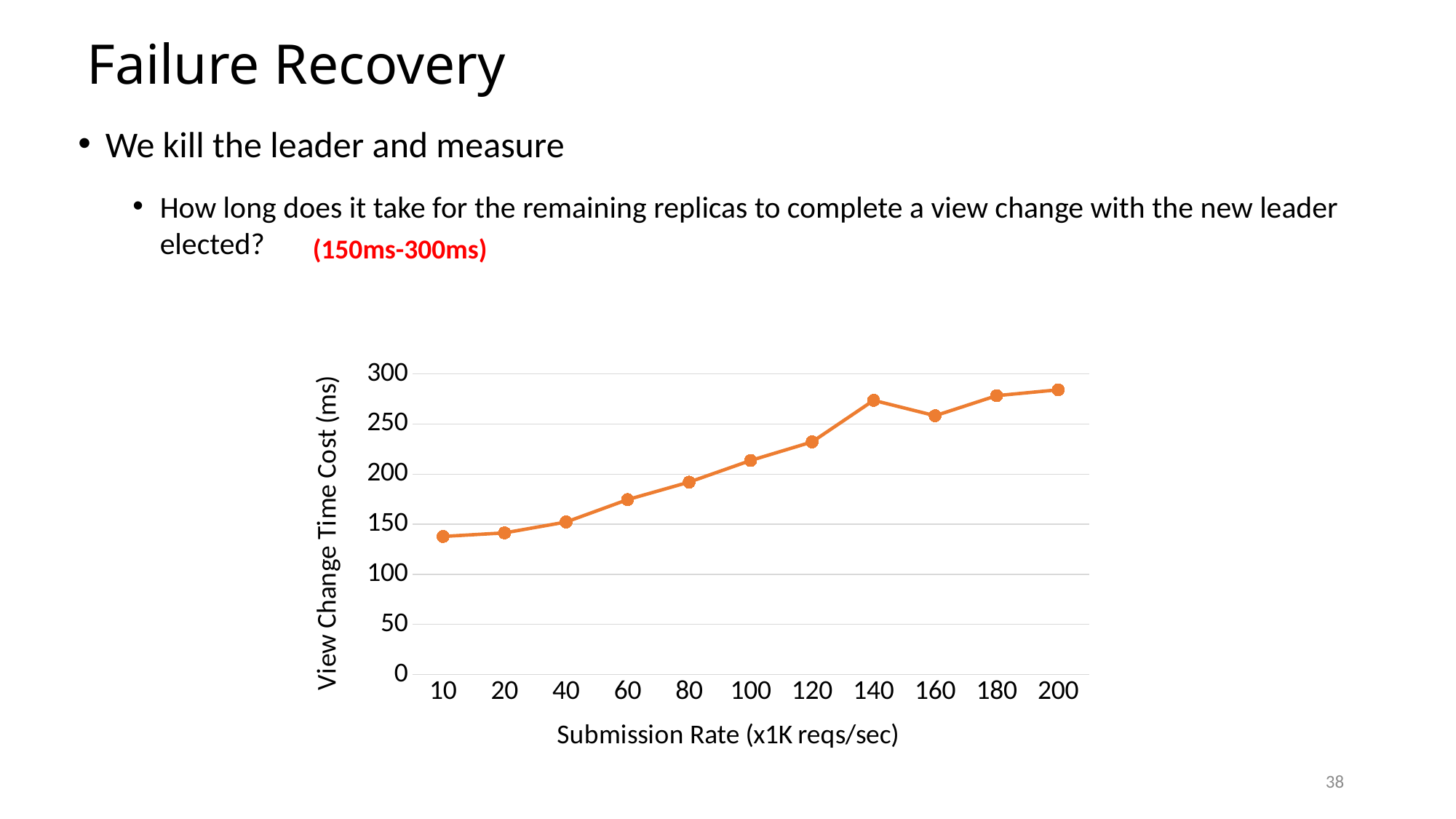
How many data points are plotted on the line? 11 Is the view change time cost at a submission rate of 200 greater or less than 300? less Is the view change time cost at a submission rate of 120 greater or less than 200? greater At which submission rate is the view change time cost highest? 200 Is the view change time cost at a submission rate of 60 greater or less than 150? greater Which has a higher view change time cost: a submission rate of 140 or 160? 140 At which submission rate is the view change time cost lowest? 10 What is the label of the y axis? View Change Time Cost (ms) Does the view change time cost generally rise or fall as the submission rate increases? rise What kind of chart is shown on the slide? line chart